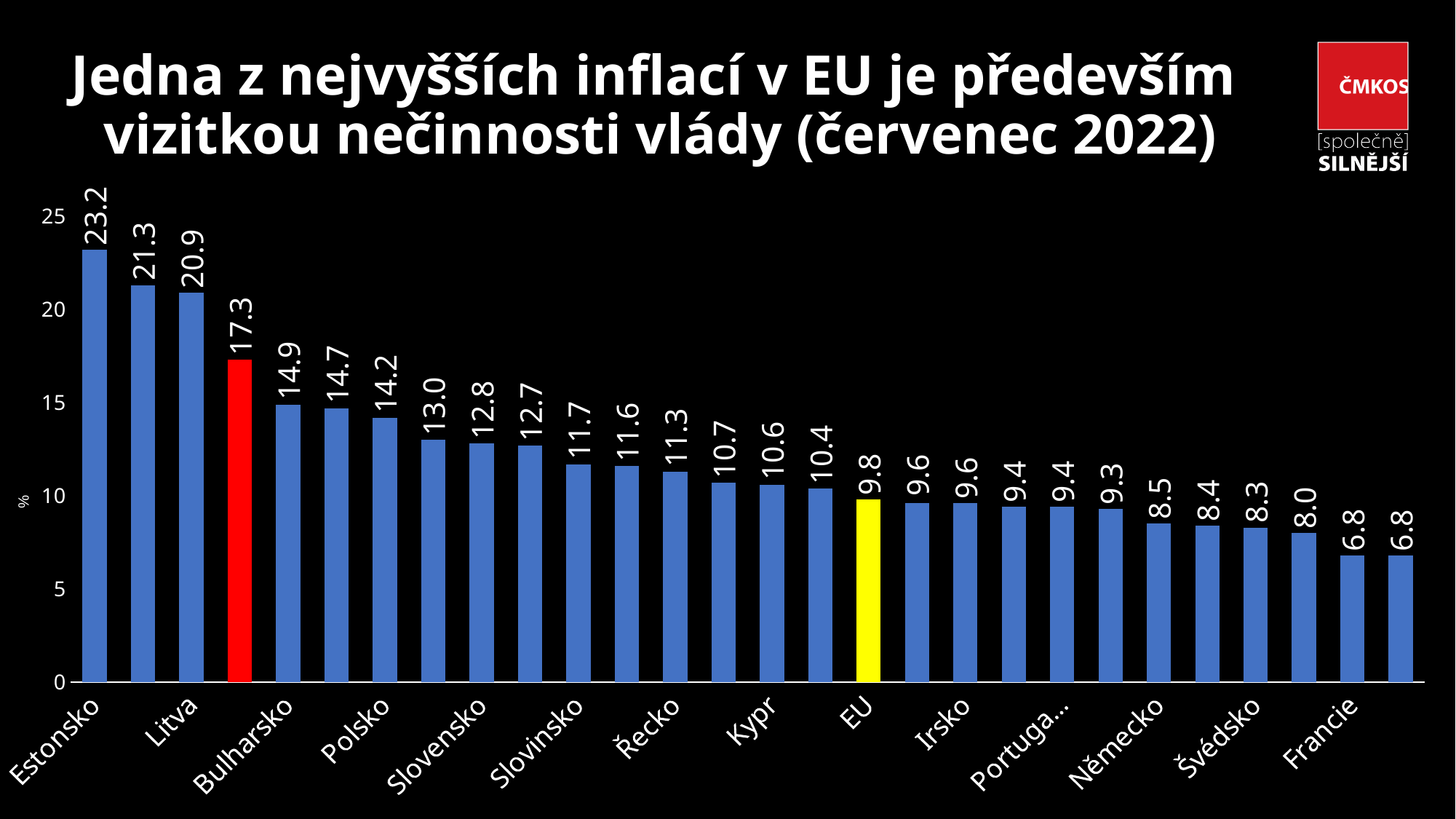
What kind of chart is shown on the slide? bar chart What is the difference between the values for Estonsko and Litva? 2.3 Which category has the highest value in the chart? Estonsko Is the value for Řecko greater or less than 10? greater What is the value shown for Polsko? 14.2 What value is shown for the EU bar? 9.8 Which has the larger value, Polsko or Slovensko? Polsko How many bars are plotted in the chart? 28 What value is shown on the red bar? 17.3 What is the inflation value shown for Estonsko? 23.2 What is the value shown for Francie? 6.8 Do the values rise or fall from left to right along the x axis? fall